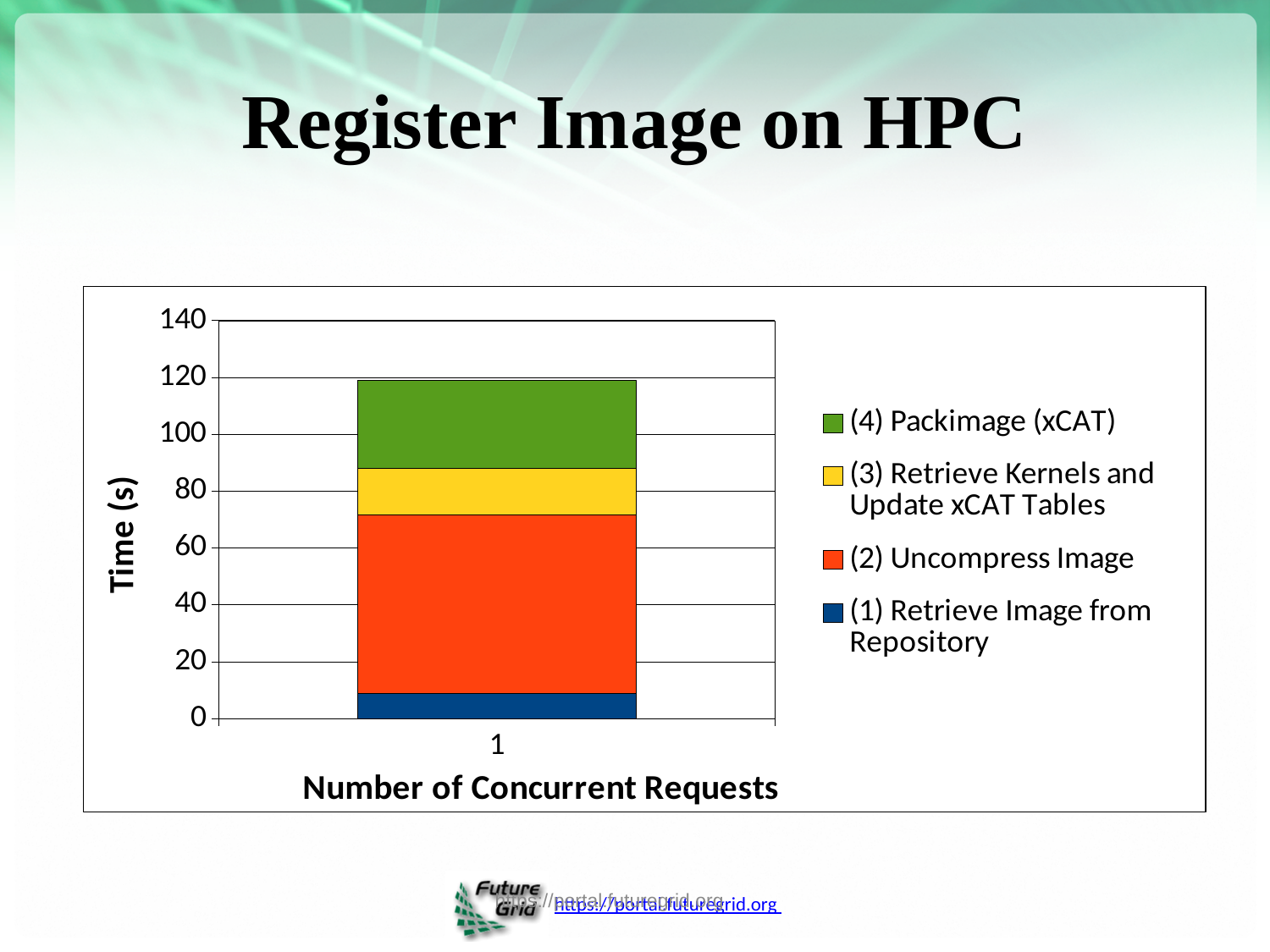
What kind of chart is shown on the slide? stacked bar chart Is the segment for (2) Uncompress Image greater or less than 40? greater How many series does the legend list? 4 Is the segment for (1) Retrieve Image from Repository greater or less than 20? less Is the total height of the stacked bar greater or less than 100? greater Which series contributes the largest segment to the stacked bar? (2) Uncompress Image What is the title of the y axis? Time (s) What is the title of the x axis? Number of Concurrent Requests Which segment is larger, (4) Packimage (xCAT) or (3) Retrieve Kernels and Update xCAT Tables? (4) Packimage (xCAT) How many categories are plotted on the x axis? 1 Which series contributes the smallest segment to the stacked bar? (1) Retrieve Image from Repository